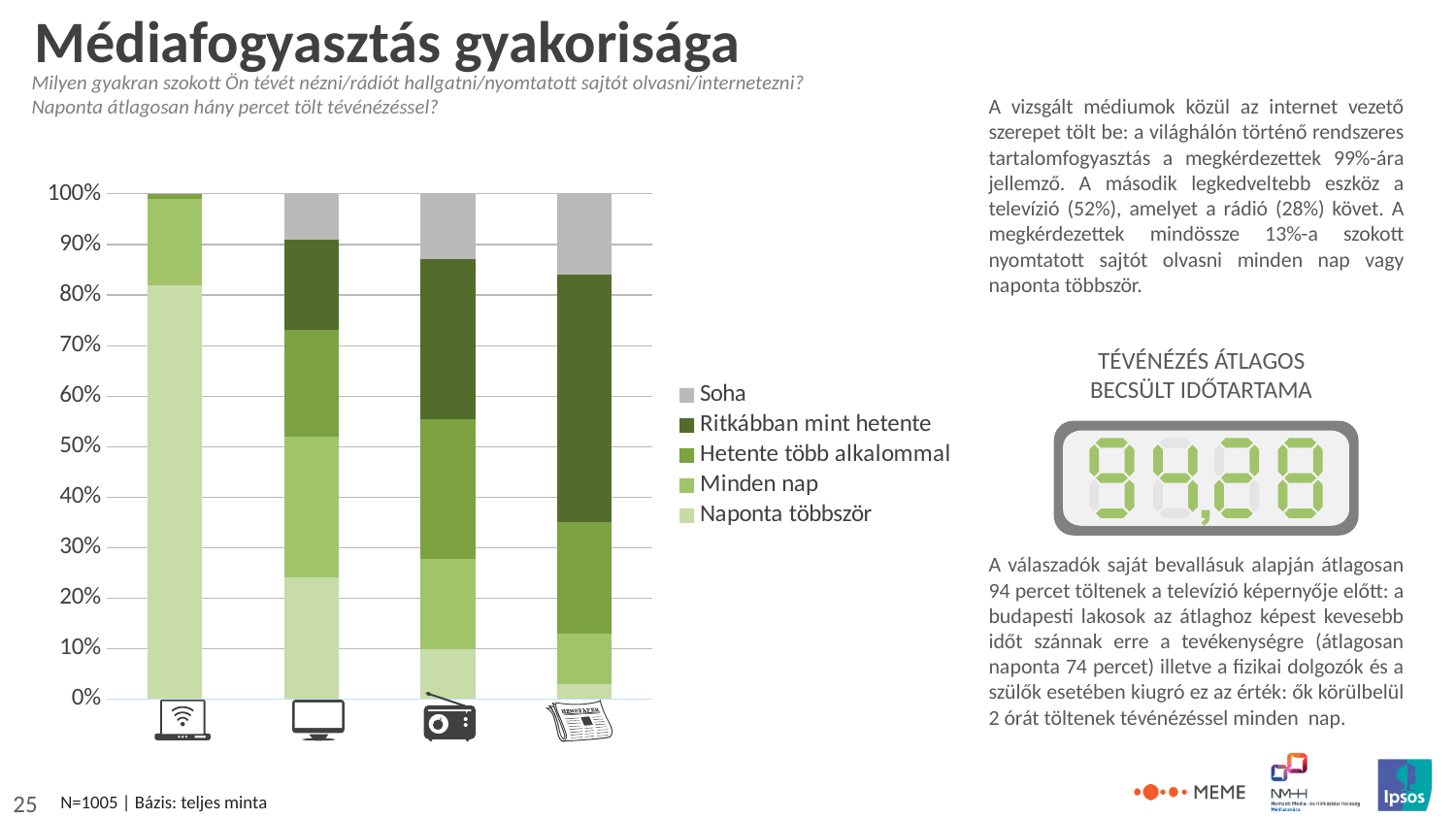
Is the 'Naponta többször' segment of the third bar (radio icon) greater or less than 20%? less Which has the larger 'Naponta többször' segment: the leftmost bar (laptop/internet icon) or the rightmost bar (newspaper icon)? The leftmost bar (laptop/internet icon) Is the 'Naponta többször' segment of the rightmost bar (newspaper icon) greater or less than 10%? less What is the title of the slide containing the chart? Médiafogyasztás gyakorisága Is the 'Naponta többször' segment of the second bar (television icon) greater or less than 30%? less How many series does the chart legend list? 5 Which bar has the largest 'Naponta többször' segment? The leftmost bar (laptop/internet icon) Which bar has the smallest 'Soha' segment? The leftmost bar (laptop/internet icon) How many bars (media categories) are plotted in the chart? 4 Which legend entry is listed first (at the top) in the chart legend? Soha What kind of chart is shown on the slide? Stacked bar chart